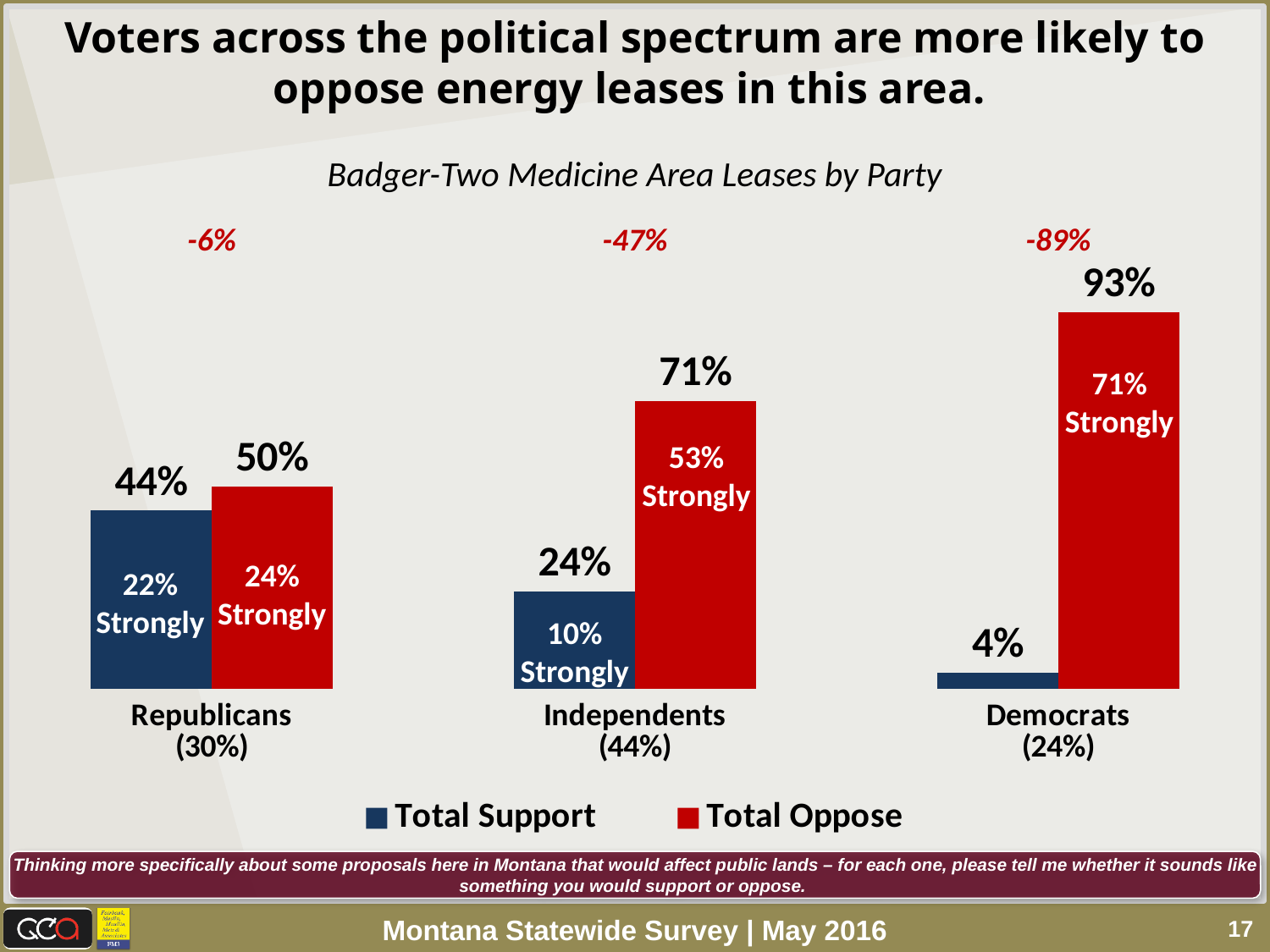
For Republicans, which is larger: Total Support or Total Oppose? Total Oppose What is the Total Support value for Democrats? 4% Which party has the lowest Total Support value? Democrats What kind of chart is shown on the slide? Bar chart Which party has the highest Total Oppose value? Democrats What is the Total Support value for Republicans? 44% What is the difference between Total Oppose and Total Support for Independents? 47% How many series does the legend list? 2 What is the Total Oppose value for Democrats? 93% How many party categories are shown on the x axis? 3 What is the Total Oppose value for Independents? 71% What is the title of the chart? Badger-Two Medicine Area Leases by Party